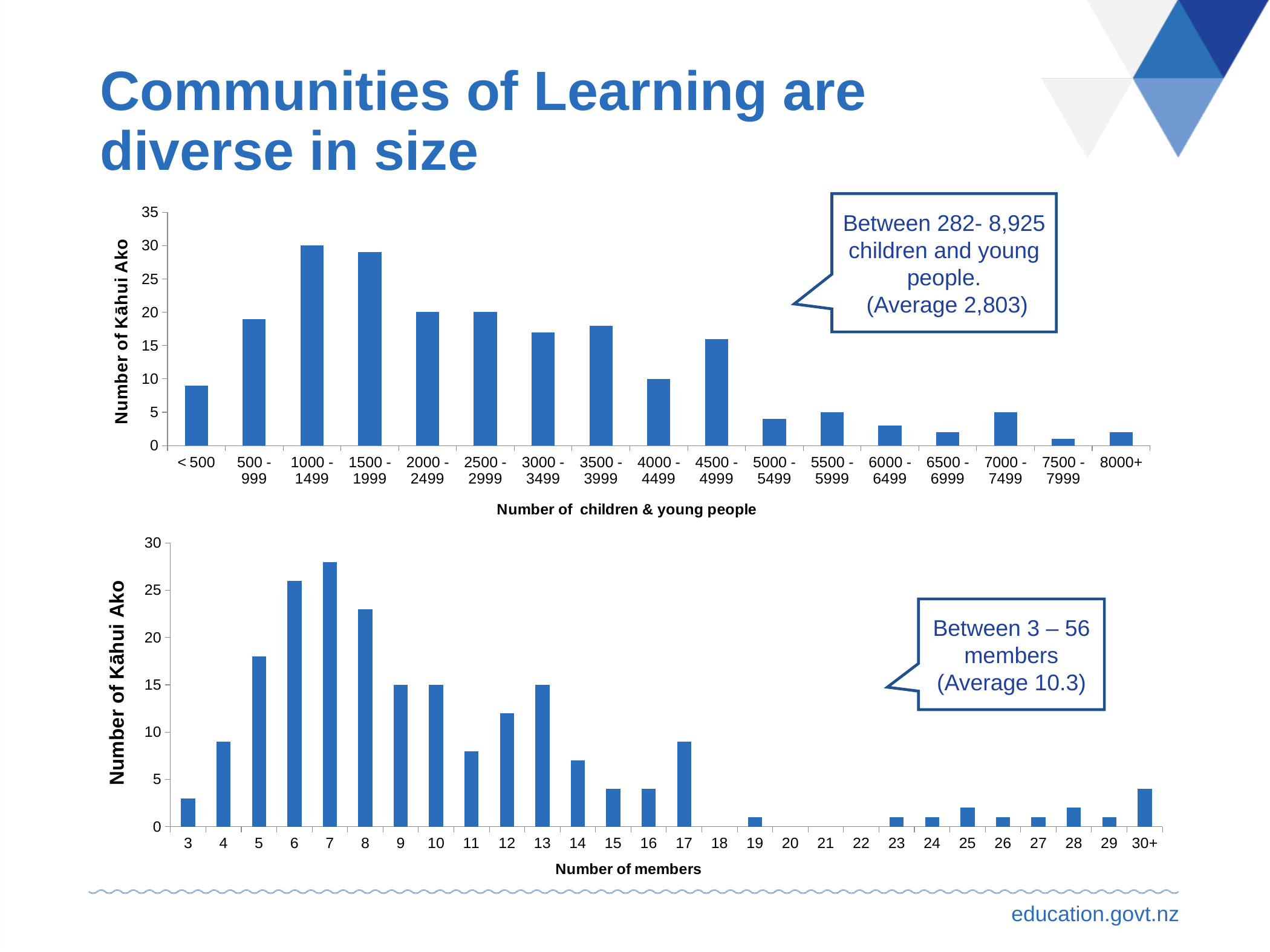
In the bottom chart (Number of members), what is the number of Kāhui Ako with 9 members? 15 In the top chart (Number of children & young people), how many categories are shown on the x axis? 17 In the top chart (Number of children & young people), is the value for 500 - 999 greater or less than 15? greater What type of chart is the top chart on the slide? bar chart In the top chart (Number of children & young people), which is larger: the value for 2000 - 2499 or the value for 5500 - 5999? 2000 - 2499 In the bottom chart (Number of members), is the value for 6 members greater or less than 20? greater In the bottom chart (Number of members), which number of members has the highest number of Kāhui Ako? 7 In the top chart (Number of children & young people), what is the number of Kāhui Ako for the 1000 - 1499 category? 30 According to the callout on the top chart, what is the average number of children and young people? 2,803 In the top chart (Number of children & young people), what is the number of Kāhui Ako for the 4000 - 4499 category? 10 In the bottom chart (Number of members), which is larger: the value for 5 members or the value for 17 members? 5 members In the top chart (Number of children & young people), which category has the highest number of Kāhui Ako? 1000 - 1499